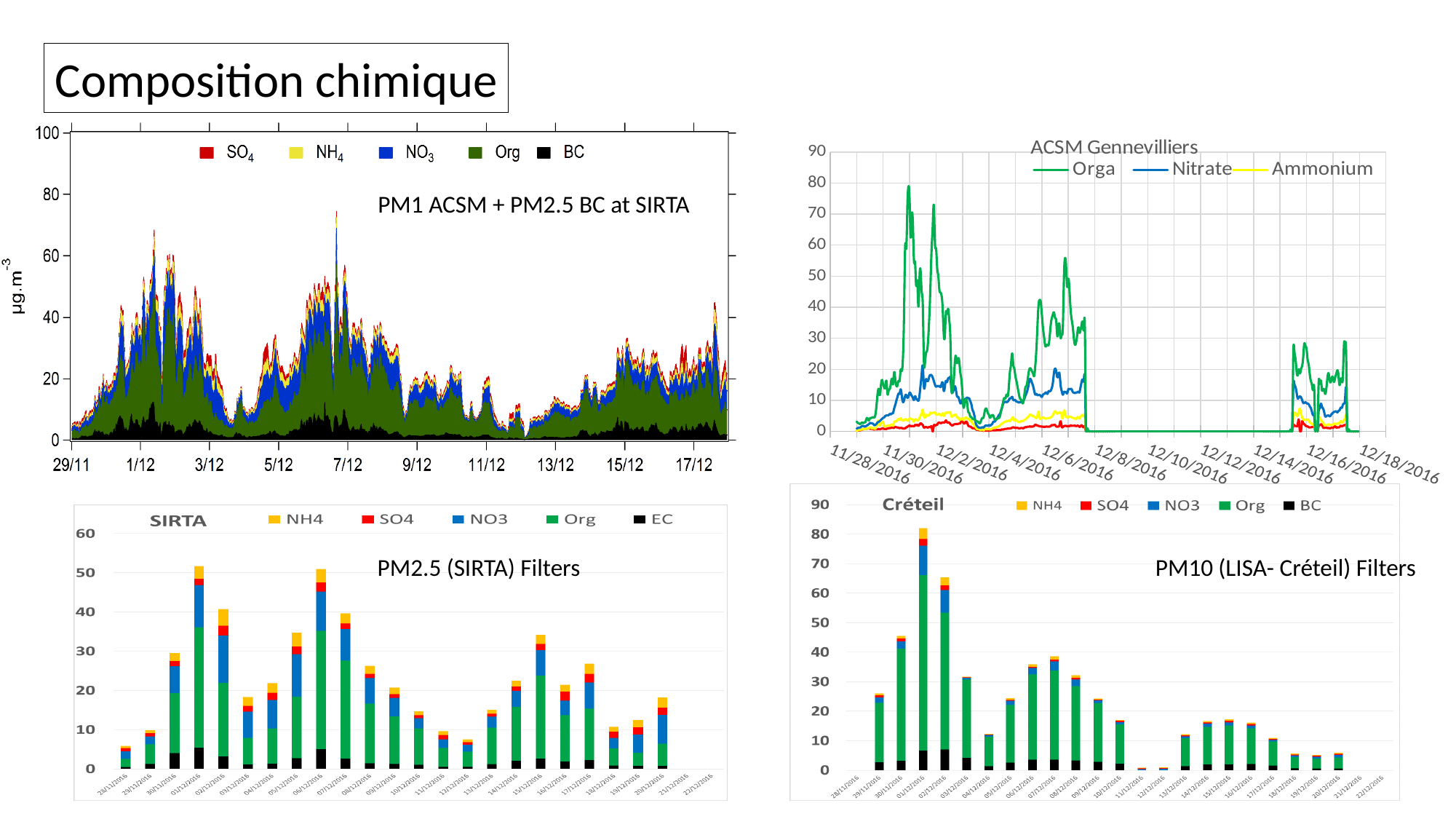
In the top-right chart titled 'ACSM Gennevilliers', how many series does the legend list? 3 In the top-right chart titled 'ACSM Gennevilliers', which series reaches the highest value? Orga In the bottom-left chart titled 'SIRTA', which series is shown in black? EC In the bottom-right chart titled 'Créteil' (PM10 LISA-Créteil Filters), which date has the highest total bar? 01/12/2016 In the bottom-right chart titled 'Créteil', which date has the larger total bar, 30/11/2016 or 03/12/2016? 30/11/2016 What kind of chart is the top-right chart titled 'ACSM Gennevilliers'? line chart In the top-right chart titled 'ACSM Gennevilliers', is the peak value of Orga greater or less than 70? greater In the bottom-left chart titled 'SIRTA', is the total for 01/12/2016 greater or less than 40? greater What kind of chart is the bottom-left chart titled 'SIRTA' (PM2.5 SIRTA Filters)? bar chart In the bottom-left chart titled 'SIRTA', how many series does the legend list? 5 In the top-left chart titled 'PM1 ACSM + PM2.5 BC at SIRTA', how many series does the legend list? 5 In the bottom-right chart titled 'Créteil', is the total for 01/12/2016 greater or less than 70? greater